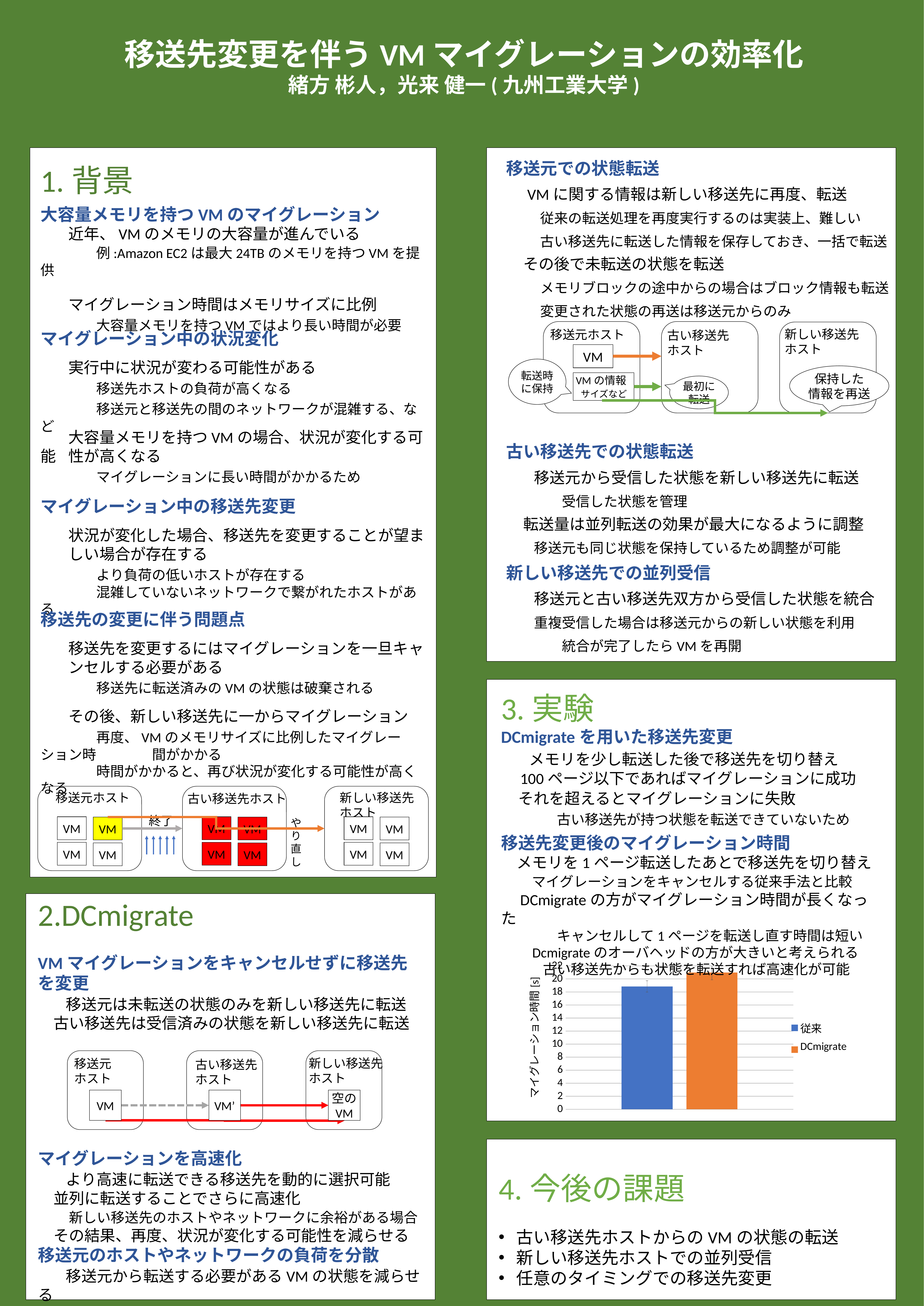
Is the migration time for 従来 greater or less than 18? greater Is the migration time for DCmigrate greater or less than 20? greater Which series has the higher migration time in the bar chart, 従来 or DCmigrate? DCmigrate Which series has the longest migration time in the bar chart? DCmigrate Is the migration time for 従来 greater or less than 20? less What kind of chart is shown in the 実験 section? bar chart Which series has the shortest migration time in the bar chart? 従来 What colour is the DCmigrate bar in the chart? orange What is the label of the vertical axis of the bar chart? マイグレーション時間 [s] How many bars are plotted in the bar chart? 2 How many series does the legend of the bar chart list? 2